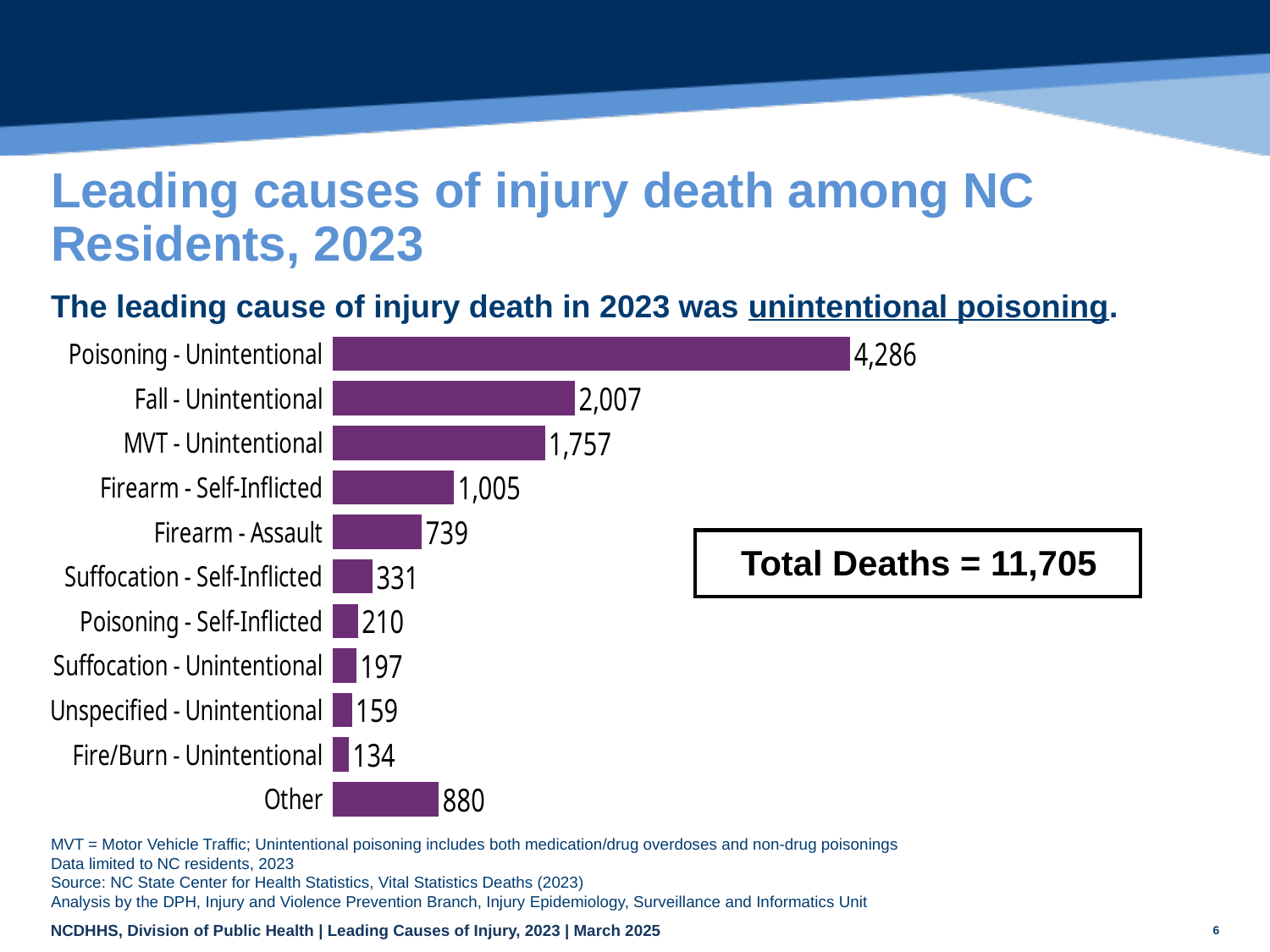
How many categories are shown in the chart? 11 Which is larger, Firearm - Self-Inflicted or Other? Firearm - Self-Inflicted What is the value for Suffocation - Self-Inflicted? 331 Which category has the highest value? Poisoning - Unintentional What kind of chart is shown on the slide? Bar chart What is the value for Poisoning - Unintentional? 4,286 What is the difference between Fall - Unintentional and MVT - Unintentional? 250 What is the value for Other? 880 What is the value for Firearm - Assault? 739 What is the difference between Poisoning - Self-Inflicted and Suffocation - Unintentional? 13 Which category has the lowest value? Fire/Burn - Unintentional What total number of deaths is stated in the box on the slide? 11,705